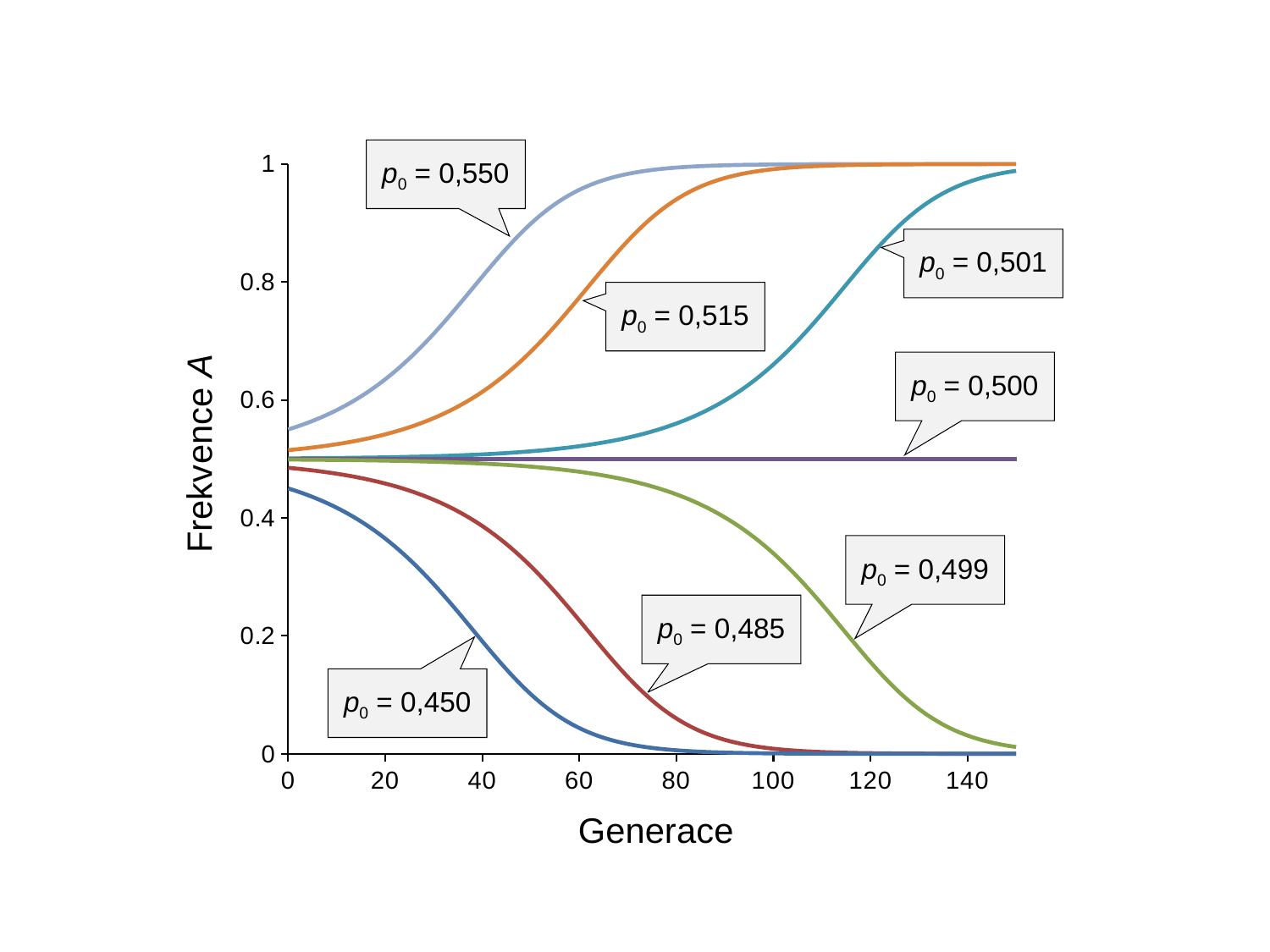
Does the curve labeled p0 = 0,500 rise, fall or stay constant across generations? stay constant Is the value of the p0 = 0,485 curve at generation 60 greater or less than 0.4? less Is the value of the p0 = 0,499 curve at generation 120 greater or less than 0.2? less What is the label of the x axis? Generace Does the curve labeled p0 = 0,450 rise or fall as the generation increases? fall Is the value of the p0 = 0,550 curve at generation 60 greater or less than 0.8? greater How many curves are plotted on the chart? 7 What is the label of the y axis? Frekvence A What kind of chart is shown on the slide? line chart Which curve reaches a frequency of 1 earliest? p0 = 0,550 At generation 60, which curve has the higher value: p0 = 0,550 or p0 = 0,515? p0 = 0,550 Does the curve labeled p0 = 0,515 rise or fall as the generation increases? rise